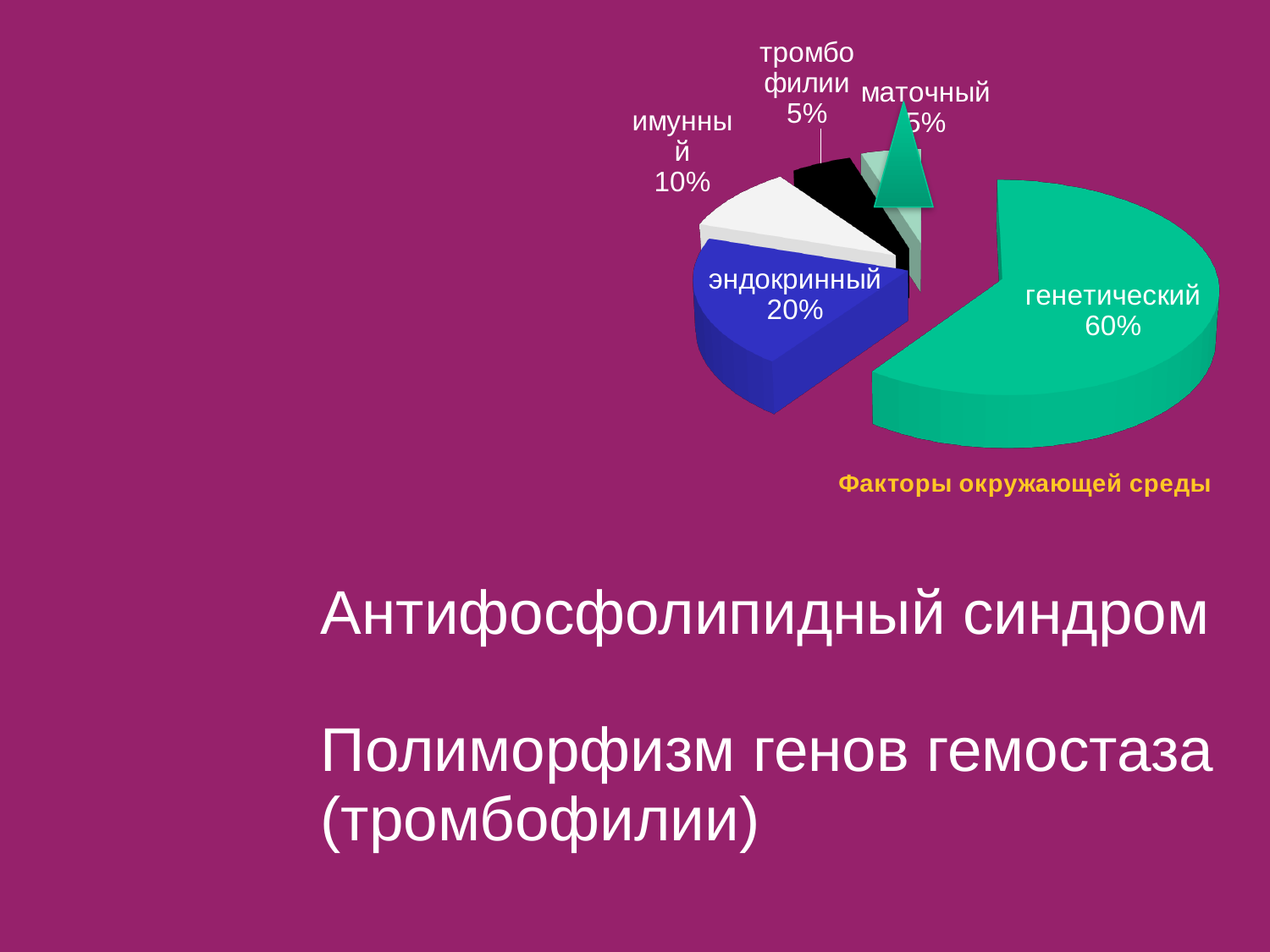
What yellow caption appears below the pie chart? Факторы окружающей среды Which is larger, the "эндокринный" slice or the "имунный" slice? эндокринный What is the difference in percentage points between the "имунный" and "тромбофилии" slices? 5 What share of the pie does the "эндокринный" slice represent? 20% What share of the pie does the "генетический" slice represent? 60% What colour is the "генетический" slice of the pie? green What share of the pie does the "имунный" slice represent? 10% What share of the pie does the "тромбофилии" slice represent? 5% What kind of chart is shown on the slide? pie chart Which slice of the pie is the largest? генетический What is the difference in percentage points between the "генетический" and "эндокринный" slices? 40 How many slices does the pie chart have? 5